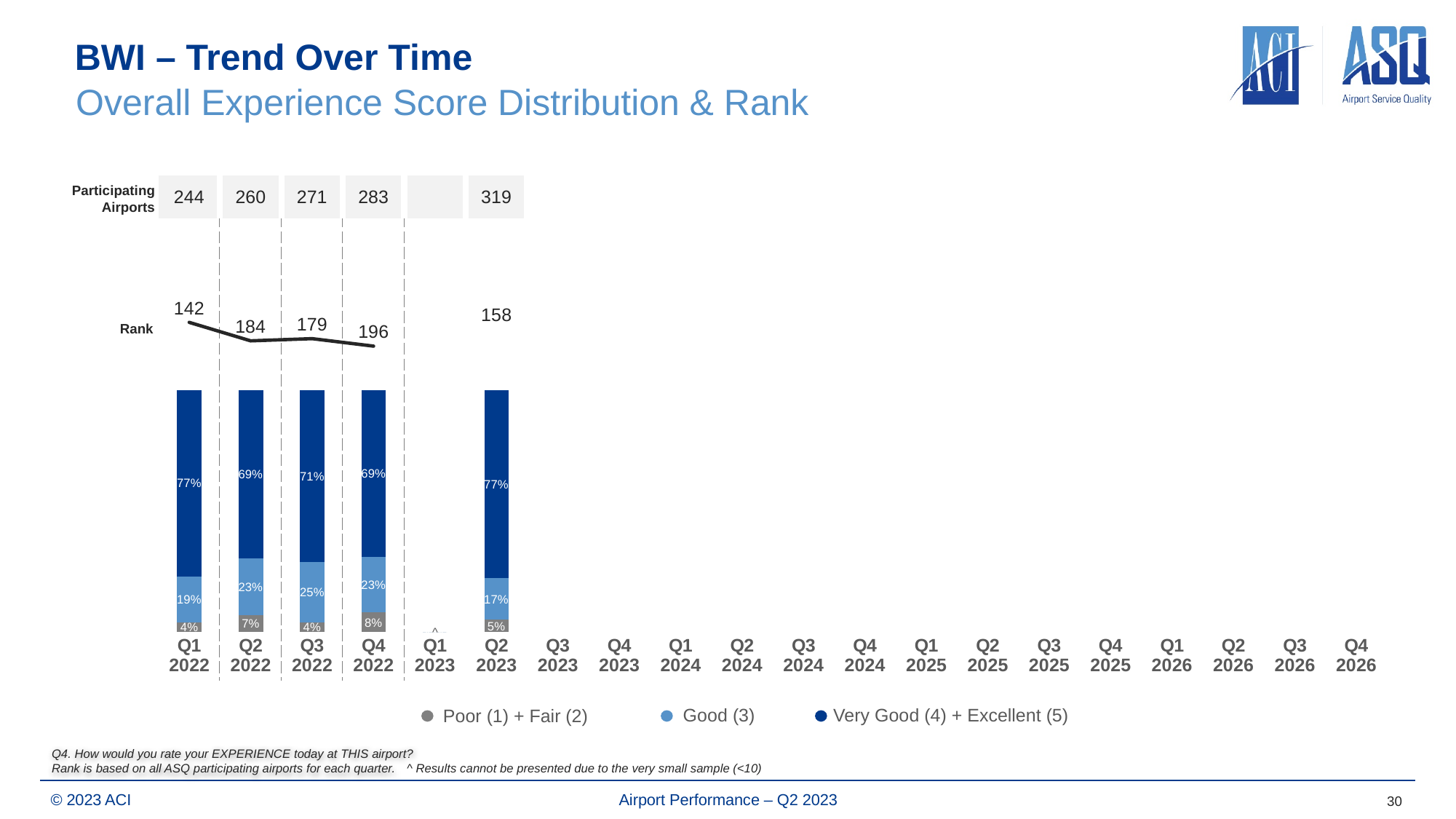
In which quarter shown was the rank value the highest (worst)? Q4 2022 What is the Good (3) share for Q3 2022? 25% How many participating airports were there in Q2 2023? 319 What kind of chart is used to show the score distribution? Stacked bar chart In which quarter shown was the rank value the lowest (best)? Q1 2022 Why is no bar shown for Q1 2023? Results cannot be presented due to the very small sample (<10) Which quarter has a larger Very Good (4) + Excellent (5) share, Q2 2022 or Q3 2022? Q3 2022 How many series does the legend list? 3 What was BWI's rank in Q2 2023? 158 What percentage of respondents rated their experience Very Good (4) + Excellent (5) in Q1 2022? 77% What is the Poor (1) + Fair (2) share for Q4 2022? 8% What is the difference between the rank in Q4 2022 and the rank in Q2 2023? 38